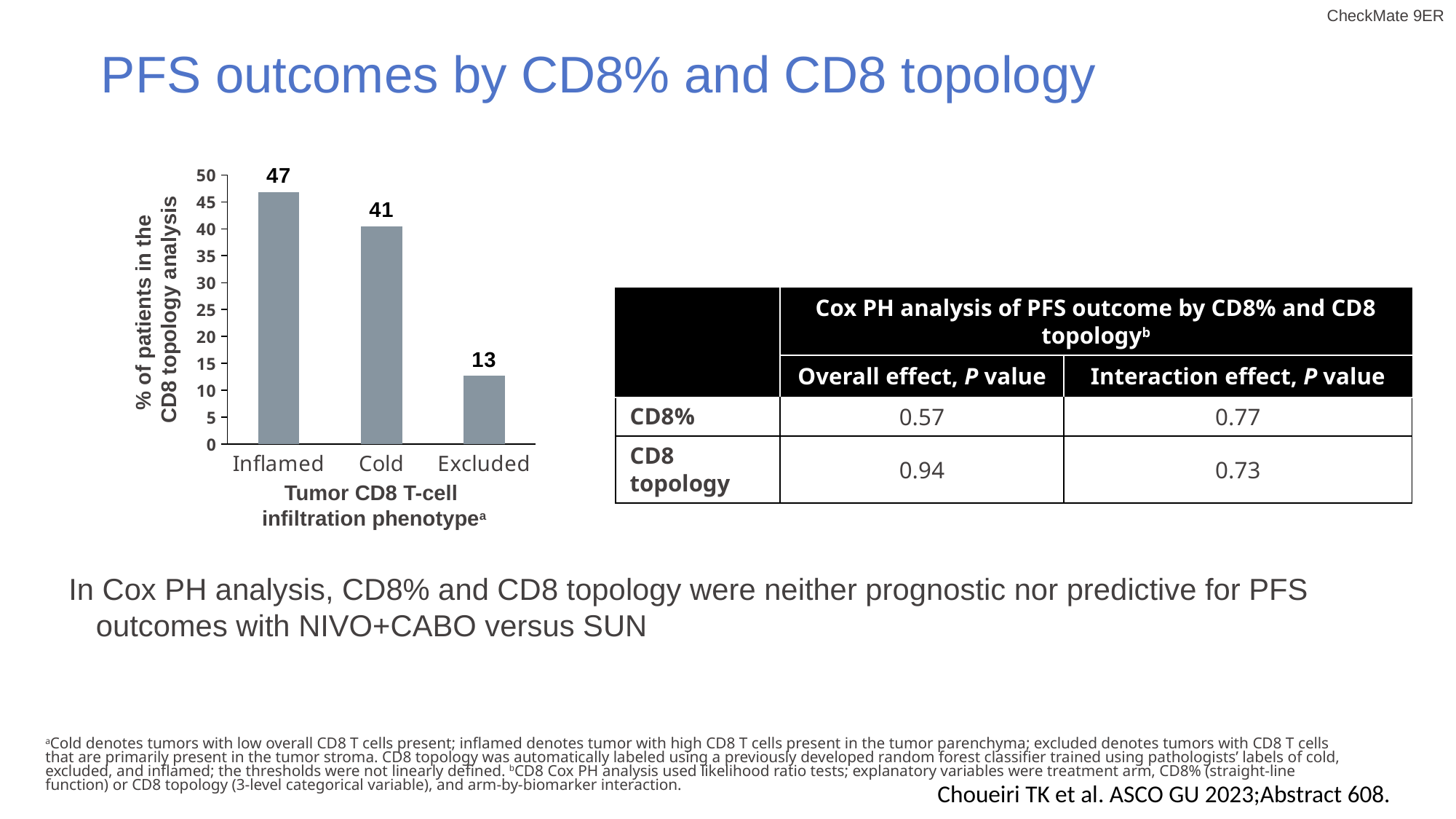
Which tumor CD8 T-cell infiltration phenotype has the highest percentage of patients? Inflamed What is the label of the y axis of the chart? % of patients in the CD8 topology analysis Is the value for the Excluded phenotype greater or less than 15? less What is the difference in percentage of patients between the Inflamed and Cold phenotypes? 6 What kind of chart is used to show the percentage of patients by CD8 T-cell infiltration phenotype? Bar chart What percentage of patients in the CD8 topology analysis had the Excluded phenotype? 13 What percentage of patients in the CD8 topology analysis had the Inflamed phenotype? 47 What percentage of patients in the CD8 topology analysis had the Cold phenotype? 41 Which tumor CD8 T-cell infiltration phenotype has the lowest percentage of patients? Excluded Which phenotype has a larger percentage of patients, Cold or Excluded? Cold How many tumor CD8 T-cell infiltration phenotype categories are shown in the chart? 3 What is the difference in percentage of patients between the Inflamed and Excluded phenotypes? 34